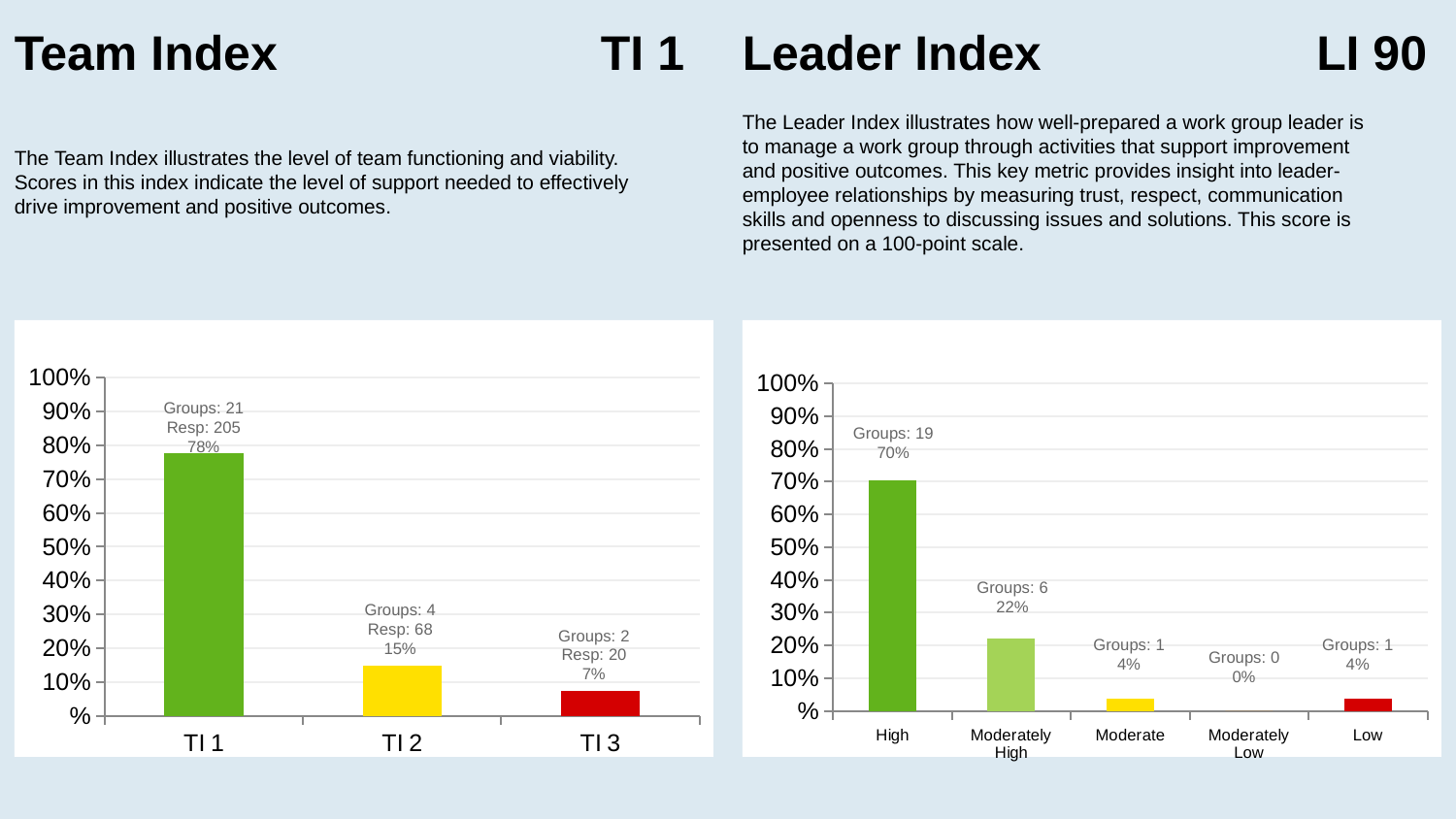
What type of chart is the Leader Index chart on the right? Bar chart In the Leader Index chart on the right, how many categories are shown on the x axis? 5 In the Leader Index chart on the right, what is the percentage value for Moderately High? 22% In the Team Index chart on the left, what is the percentage value for TI 1? 78% In the Team Index chart on the left, which category has the lowest percentage? TI 3 In the Leader Index chart on the right, which category has the highest percentage? High In the Leader Index chart on the right, what is the difference in percentage between High and Moderately High? 48% In the Team Index chart on the left, how many categories are shown on the x axis? 3 In the Team Index chart on the left, what is the difference in percentage between TI 1 and TI 2? 63% In the Team Index chart on the left, how many respondents (Resp) are shown for TI 2? 68 In the Team Index chart on the left, how many groups are shown for TI 3? 2 In the Leader Index chart on the right, how many groups are shown for High? 19